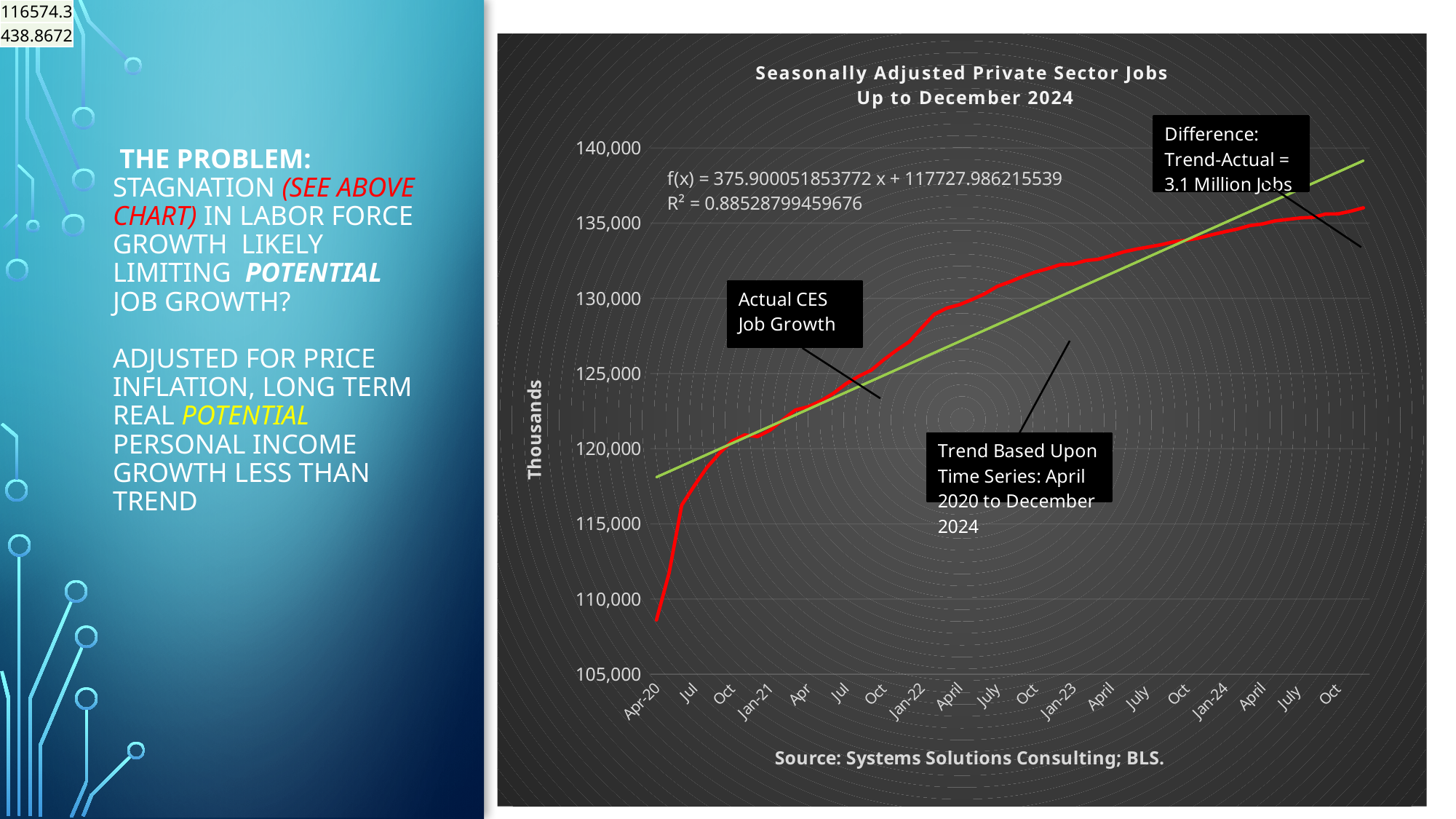
According to the annotation on the chart, what is the difference between trend and actual jobs? 3.1 Million Jobs What kind of chart is shown on the slide? line chart Is the Actual CES Job Growth value at Apr-20 greater or less than 110,000? less Does the Actual CES Job Growth line generally rise or fall from Apr-20 to the end of the series? rise Is the trend line value at the end of the series greater or less than 140,000? less Is the Actual CES Job Growth value at Jan-22 greater or less than 125,000? greater What is the title of the chart? Seasonally Adjusted Private Sector Jobs Up to December 2024 What is the label on the vertical axis of the chart? Thousands At Apr-20, which is higher: the Actual CES Job Growth line or the trend line? the trend line At Jan-23, which is higher: the Actual CES Job Growth line or the trend line? the Actual CES Job Growth line